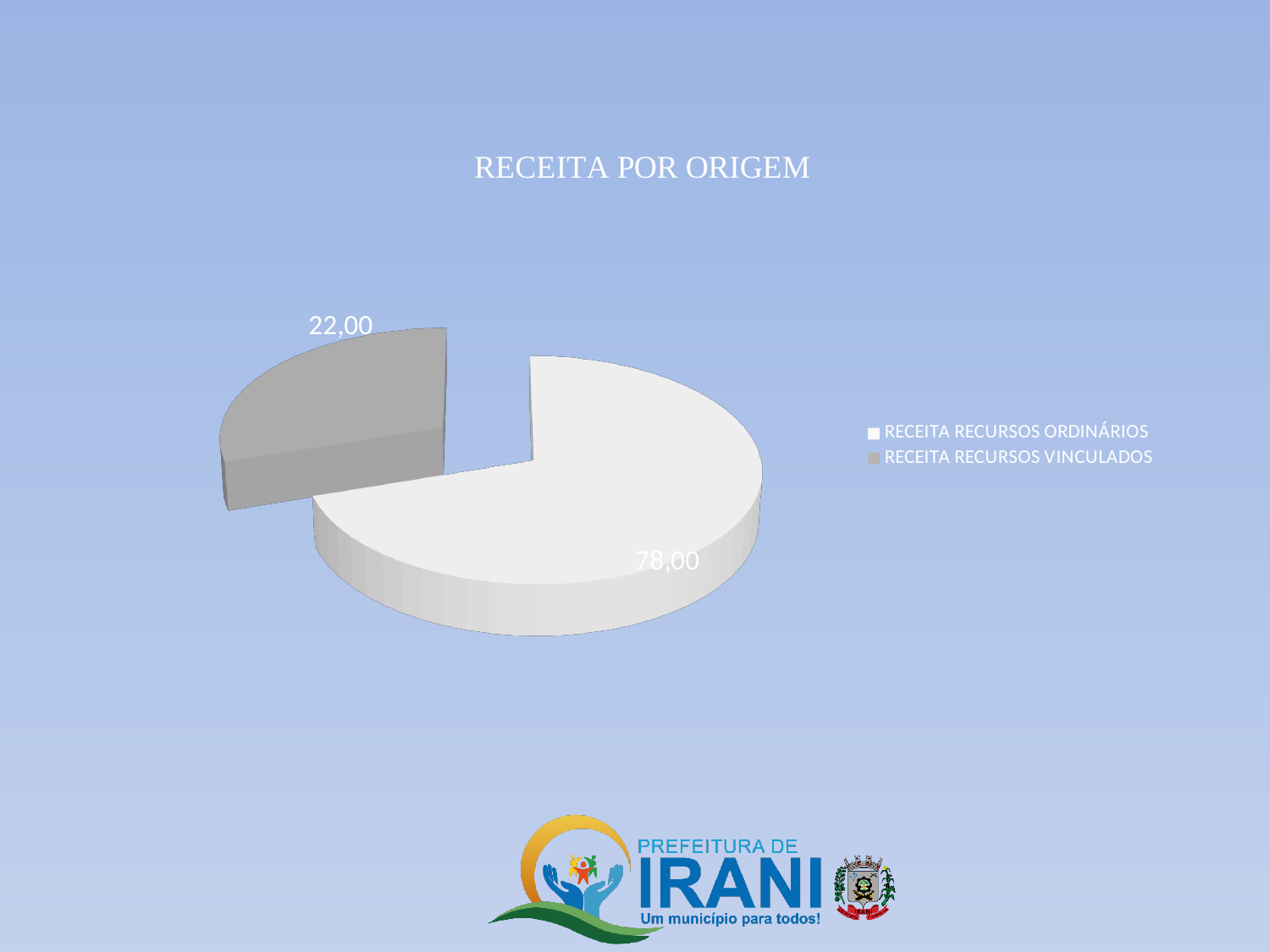
Which category has the largest slice of the pie? RECEITA RECURSOS ORDINÁRIOS Which category has the smallest slice of the pie? RECEITA RECURSOS VINCULADOS What is the value shown for RECEITA RECURSOS VINCULADOS? 22,00 Which legend entry is shown in grey? RECEITA RECURSOS VINCULADOS What is the value shown for RECEITA RECURSOS ORDINÁRIOS? 78,00 What is the difference between the values for RECEITA RECURSOS ORDINÁRIOS and RECEITA RECURSOS VINCULADOS? 56,00 Which is larger, RECEITA RECURSOS ORDINÁRIOS or RECEITA RECURSOS VINCULADOS? RECEITA RECURSOS ORDINÁRIOS What is the title of the chart? RECEITA POR ORIGEM What kind of chart is shown on the slide? Pie chart How many entries does the legend list? 2 How many slices does the pie chart have? 2